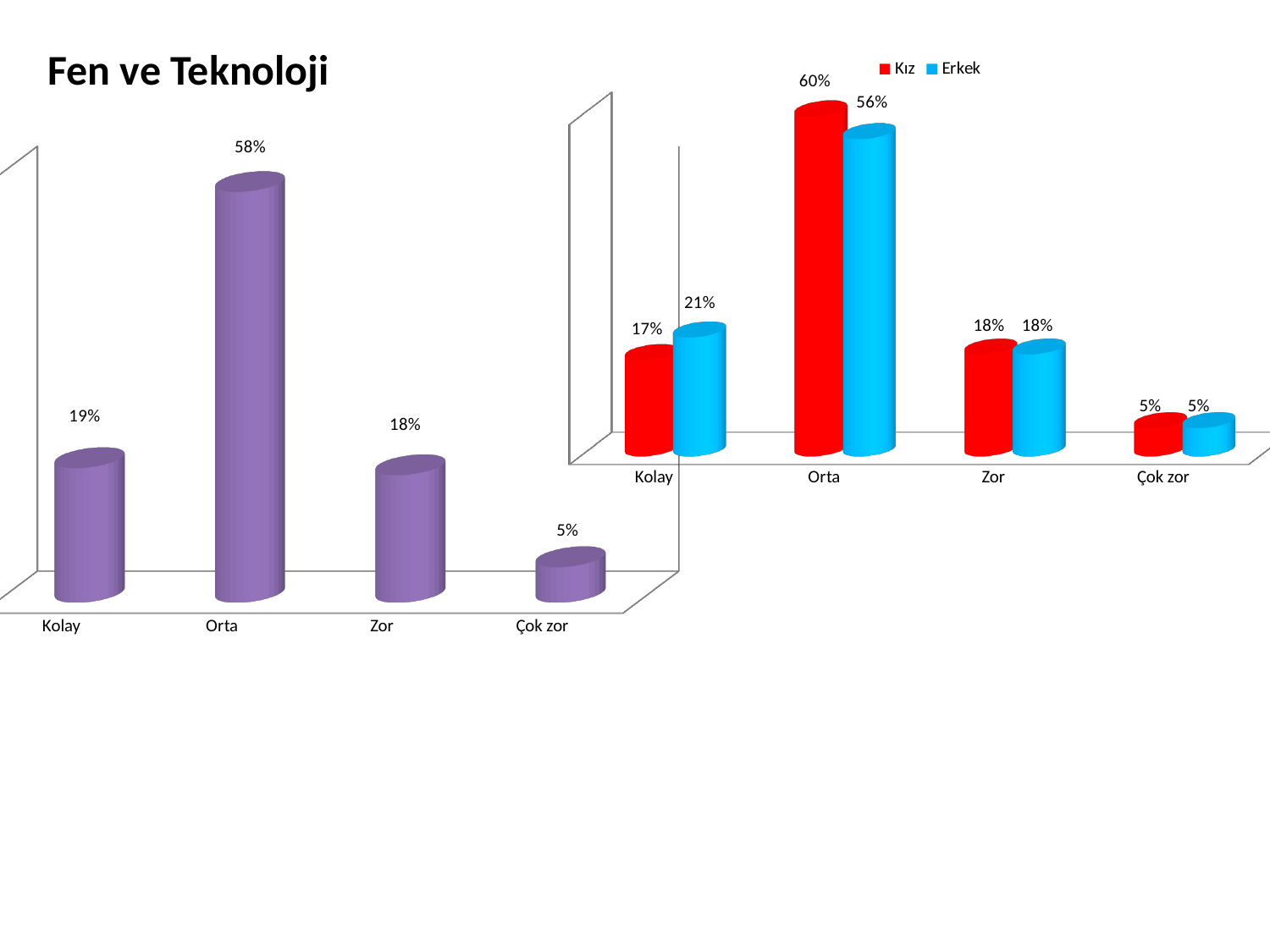
In the right chart, which colour represents the Erkek series? Blue In the right chart, what is the Erkek value for Kolay? 21% In the left chart, how many categories are shown? 4 In the right chart, what is the difference between the Kız and Erkek values for Kolay? 4% In the right chart, which is larger for Orta, Kız or Erkek? Kız In the right chart, what is the Kız value for Orta? 60% In the left chart, what is the value for Orta? 58% In the right chart, how many series does the legend list? 2 In the left chart, what is the value for Kolay? 19% In the left chart, what is the difference between the values for Orta and Zor? 40% In the left chart, which category has the lowest value? Çok zor What kind of chart is the right chart? Bar chart